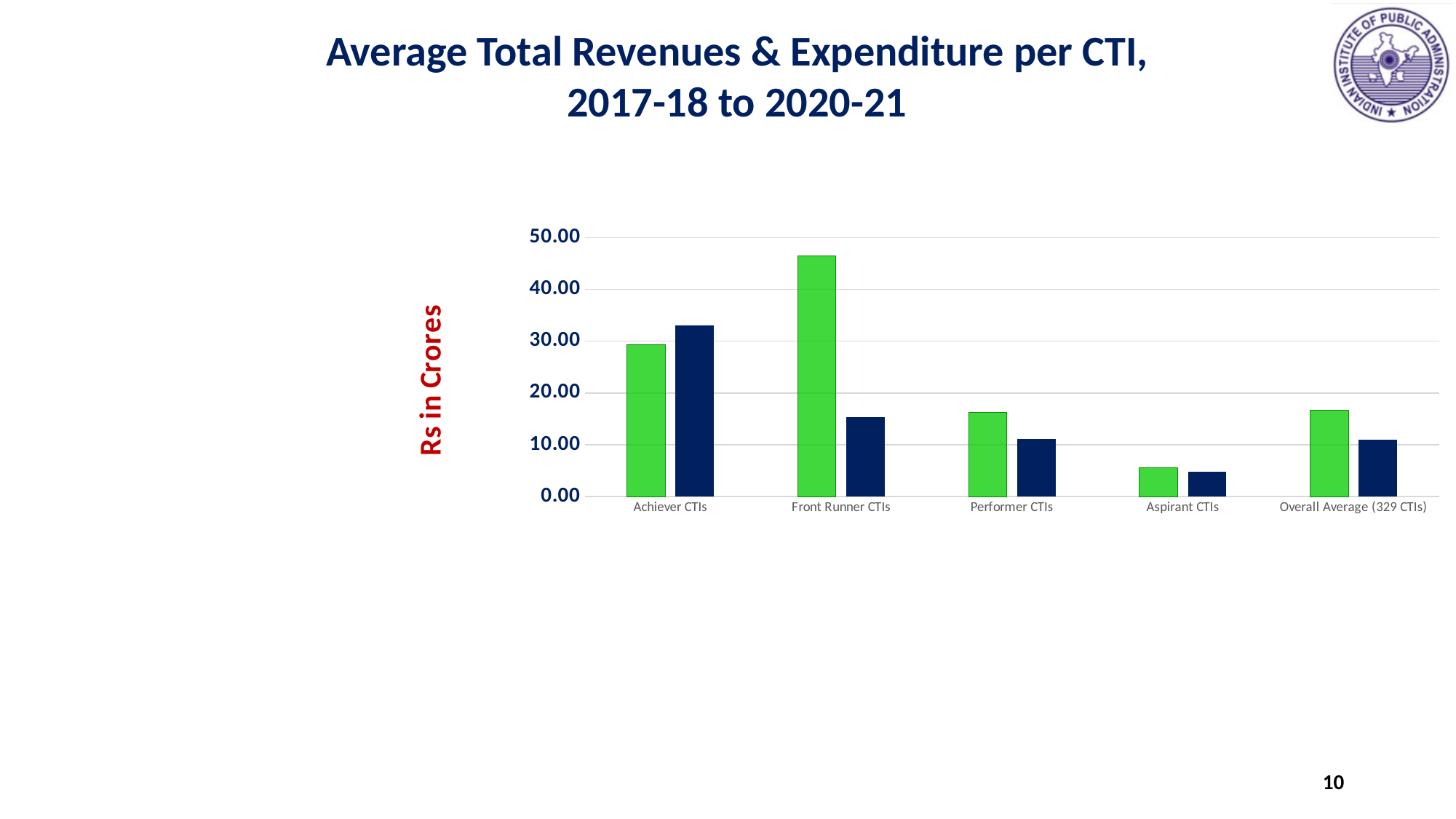
What is the title of the chart on the slide? Average Total Revenues & Expenditure per CTI, 2017-18 to 2020-21 Is the green bar for Aspirant CTIs greater or less than 10.00? less Which category has the tallest green bar? Front Runner CTIs Which category has the shortest green bar? Aspirant CTIs For Front Runner CTIs, which bar is taller, the green bar or the dark blue bar? the green bar How many categories are shown on the x axis of the chart? 5 Which category has the tallest dark blue bar? Achiever CTIs What is the label on the vertical axis of the chart? Rs in Crores Is the dark blue bar for Achiever CTIs greater or less than 30.00? greater Is the green bar for Front Runner CTIs greater or less than 40.00? greater Which category has the shortest dark blue bar? Aspirant CTIs What kind of chart is shown on the slide? bar chart